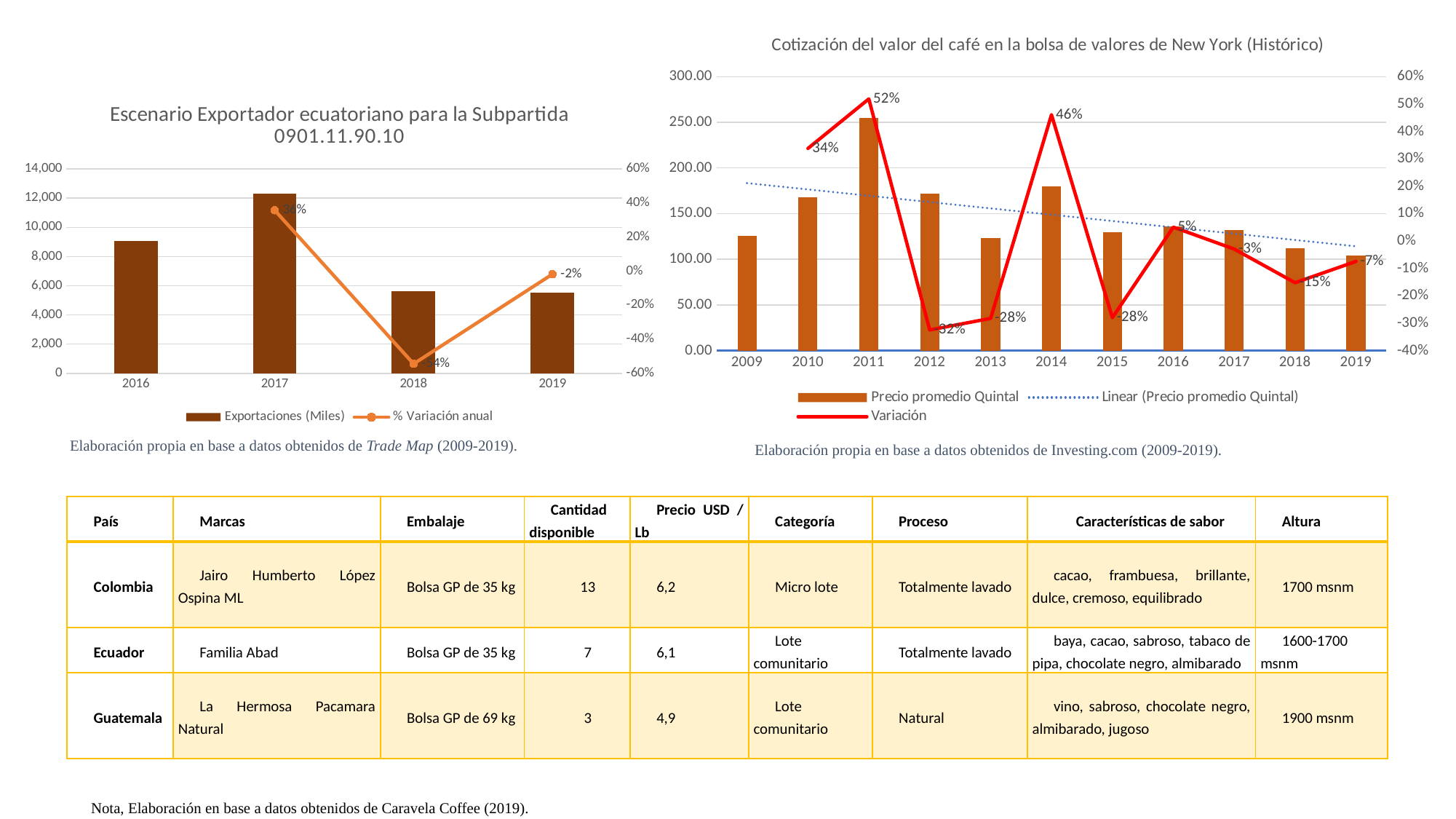
In the right chart (Cotización del valor del café), what is the difference between the Variación for 2011 and the Variación for 2010? 18 percentage points In the right chart (Cotización del valor del café), is the Precio promedio Quintal for 2009 greater or less than 150.00? less In the left chart (Escenario Exportador ecuatoriano), is the Exportaciones value for 2017 greater or less than 10,000? greater In the right chart (Cotización del valor del café), what is the Variación for 2014? 46% In the left chart (Escenario Exportador ecuatoriano), which year has the highest Exportaciones (Miles)? 2017 How many series does the legend of the right chart (Cotización del valor del café) list? 3 What kind of chart is the left chart titled 'Escenario Exportador ecuatoriano para la Subpartida 0901.11.90.10'? A combined bar and line chart In the right chart (Cotización del valor del café), which year has the larger Precio promedio Quintal, 2012 or 2013? 2012 In the left chart (Escenario Exportador ecuatoriano), what is the % Variación anual for 2019? -2% In the right chart (Cotización del valor del café), what is the Variación for 2011? 52% How many years are shown on the x axis of the left chart (Escenario Exportador ecuatoriano)? 4 In the right chart (Cotización del valor del café), which year has the highest Precio promedio Quintal? 2011